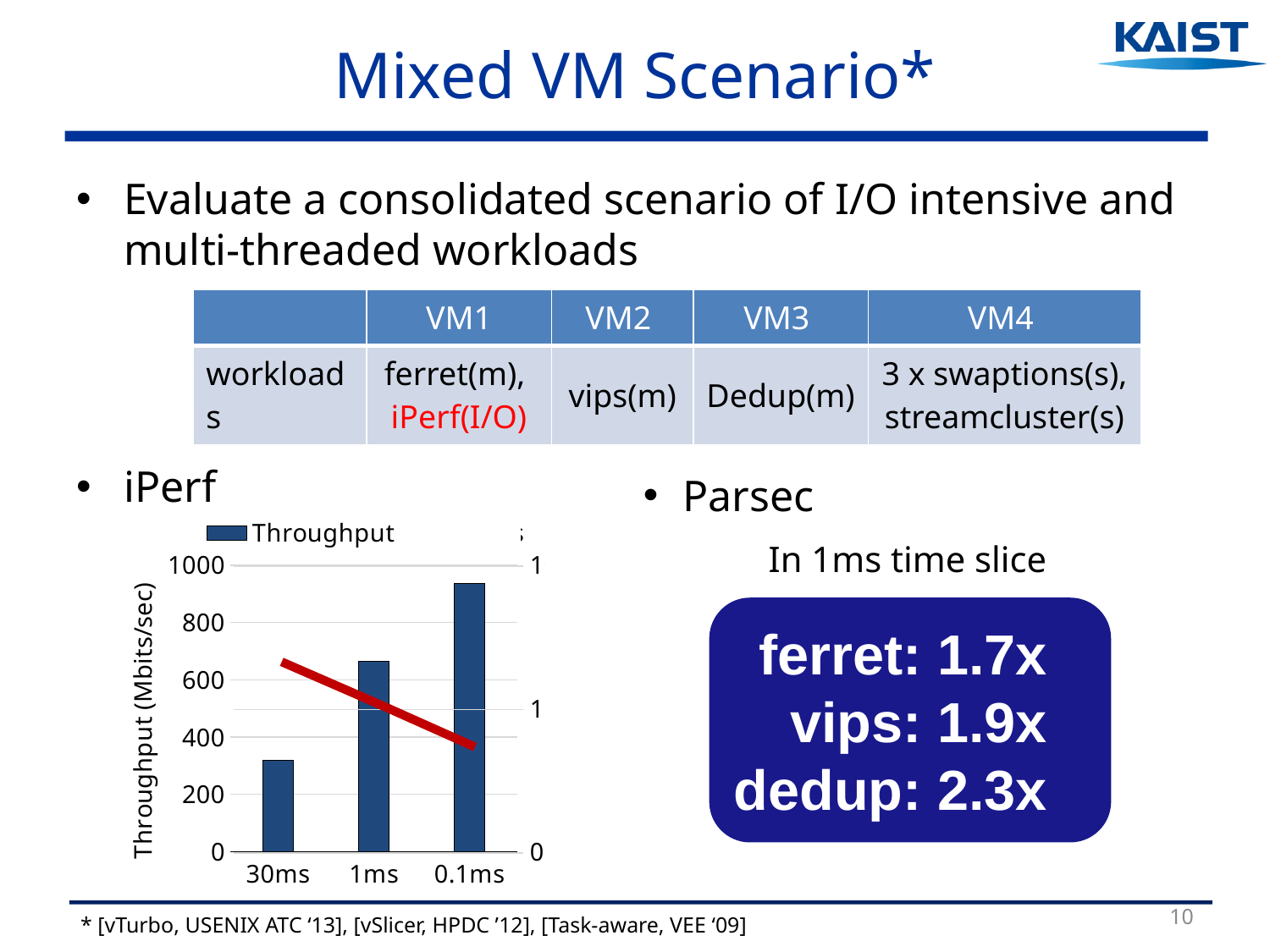
Is the throughput for 0.1ms in the iPerf chart greater or less than 800? greater What is the readable legend entry for the bars in the iPerf chart? Throughput In the iPerf chart, is the throughput higher for 1ms or for 30ms? 1ms What is the label of the vertical axis in the iPerf chart? Throughput (Mbits/sec) Is the throughput for 1ms in the iPerf chart greater or less than 600? greater Which time slice has the highest throughput in the iPerf chart? 0.1ms How many time-slice categories are shown on the x axis of the iPerf chart? 3 Which time slice has the lowest throughput in the iPerf chart? 30ms Is the throughput for 30ms in the iPerf chart greater or less than 400? less What kind of chart is shown under the iPerf heading? bar chart In the iPerf chart, is the throughput higher for 0.1ms or for 1ms? 0.1ms Does throughput rise or fall along the x axis from 30ms to 0.1ms in the iPerf chart? rise